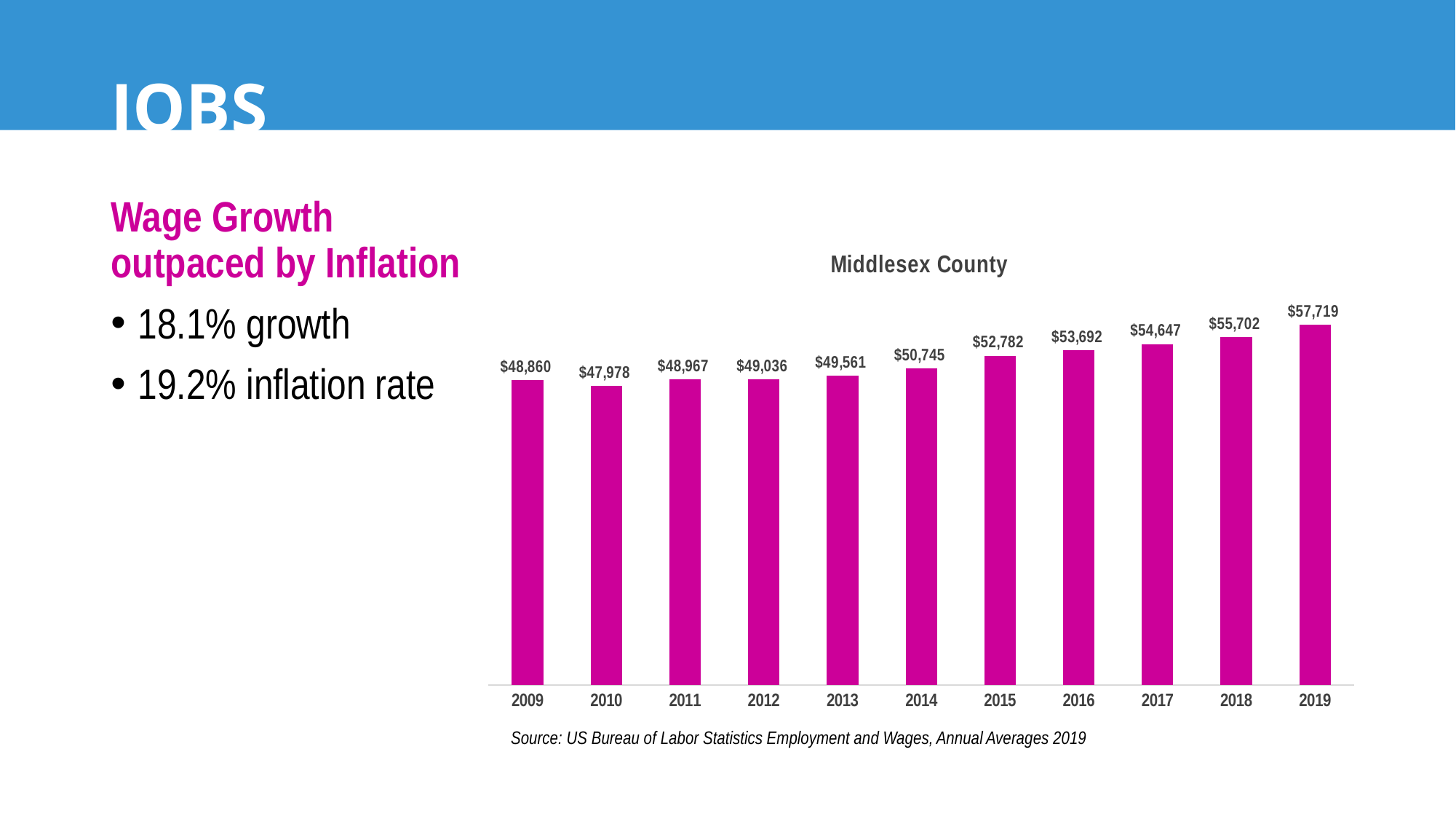
What is the value for 2009? $48,860 What is the value for 2015? $52,782 Which year has the lowest value? 2010 What is the difference between the values for 2018 and 2017? $1,055 Do the values generally rise or fall from 2010 to 2019? Rise Which year has the highest value? 2019 What is the value for 2019? $57,719 Which is larger, the value for 2010 or the value for 2011? 2011 What is the title of the chart? Middlesex County What kind of chart is this? Bar chart How many years are shown on the x axis? 11 What is the difference between the values for 2019 and 2009? $8,859